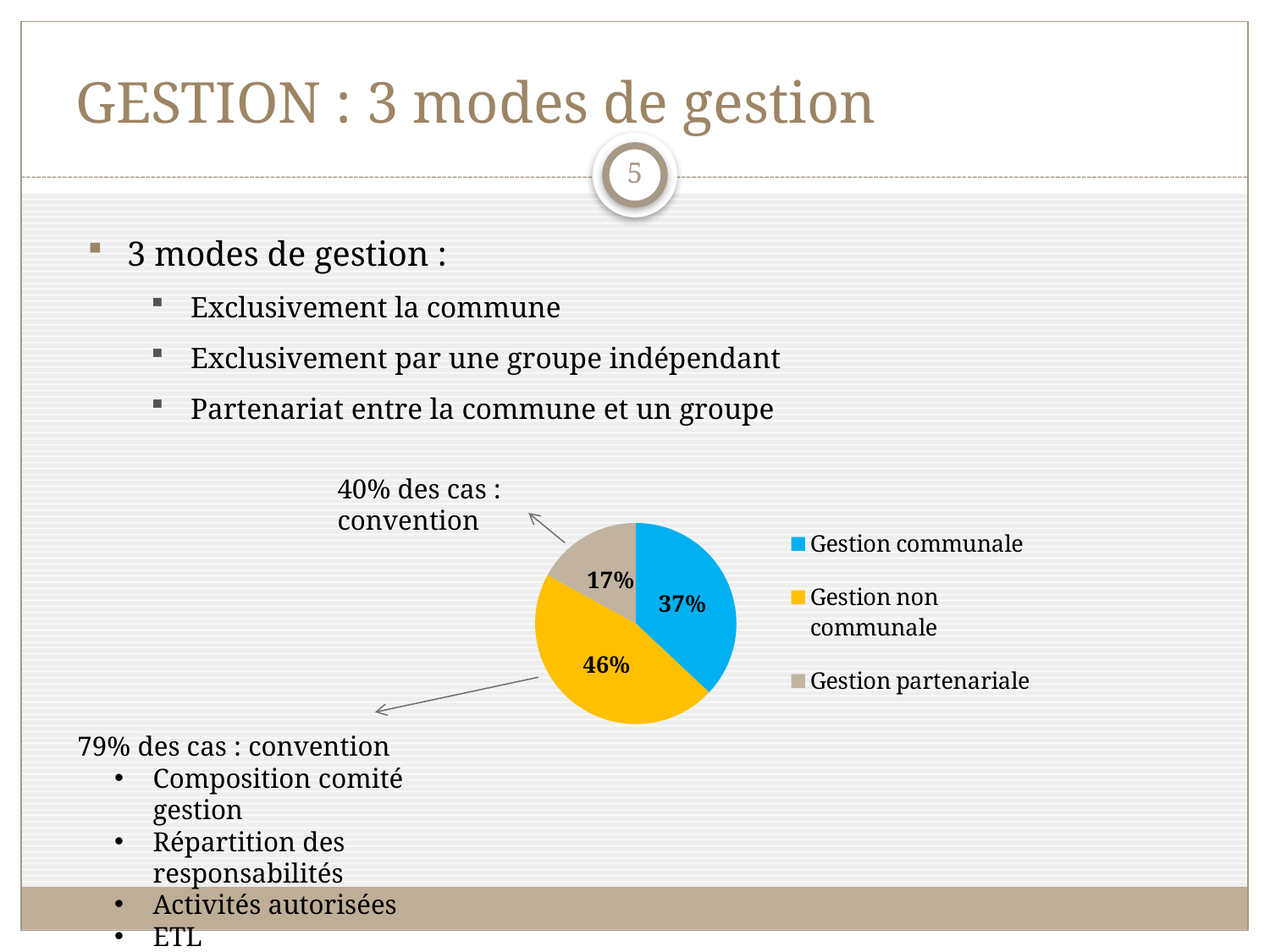
How many entries does the legend list? 3 What share of the pie is Gestion communale? 37% What colour is the Gestion non communale slice? yellow How many slices does the pie chart have? 3 What is the difference in percentage points between Gestion communale and Gestion partenariale? 20 What share of the pie is Gestion partenariale? 17% What is the difference in percentage points between Gestion non communale and Gestion communale? 9 Which category has the smallest slice of the pie? Gestion partenariale Which is larger, Gestion communale or Gestion partenariale? Gestion communale What kind of chart is shown on the slide? pie chart What share of the pie is Gestion non communale? 46% Which category has the largest slice of the pie? Gestion non communale